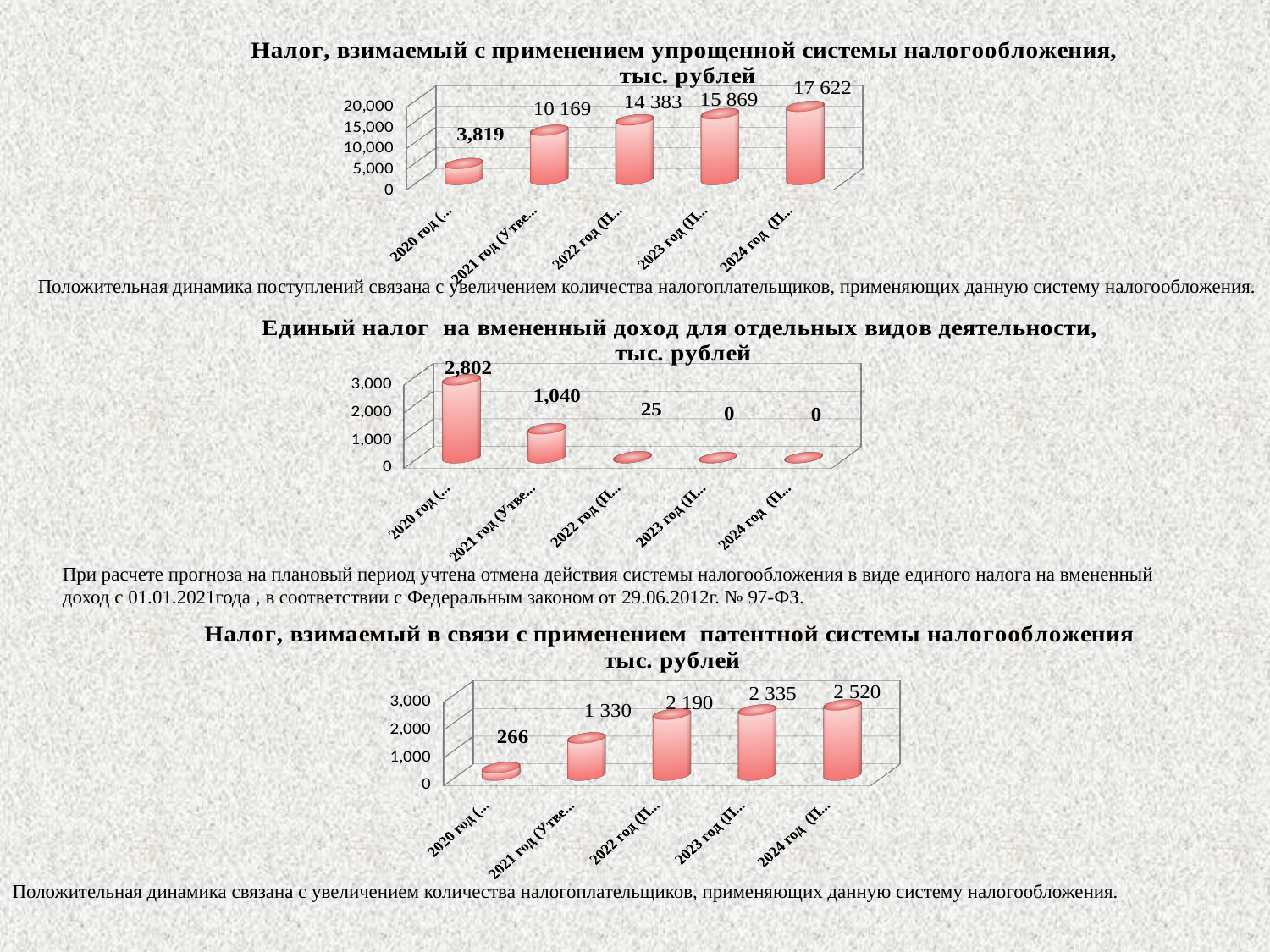
On the top chart (simplified taxation system), which year has the highest value? 2024 On the middle chart (single tax on imputed income), what is the value for 2021? 1,040 On the top chart (simplified taxation system), what is the value for 2024? 17 622 On the bottom chart (patent taxation system), what is the value for 2023? 2 335 On the top chart (simplified taxation system), what is the value for 2020? 3,819 On the middle chart (single tax on imputed income), what is the value for 2022? 25 On the top chart (simplified taxation system), do the values rise or fall from 2020 to 2024? rise On the middle chart (single tax on imputed income), how many bars are plotted? 5 On the middle chart (single tax on imputed income), which year has the highest value? 2020 On the bottom chart (patent taxation system), which is larger, the value for 2022 or the value for 2024? 2024 What kind of chart is the bottom chart (patent taxation system)? bar chart On the bottom chart (patent taxation system), which year has the lowest value? 2020